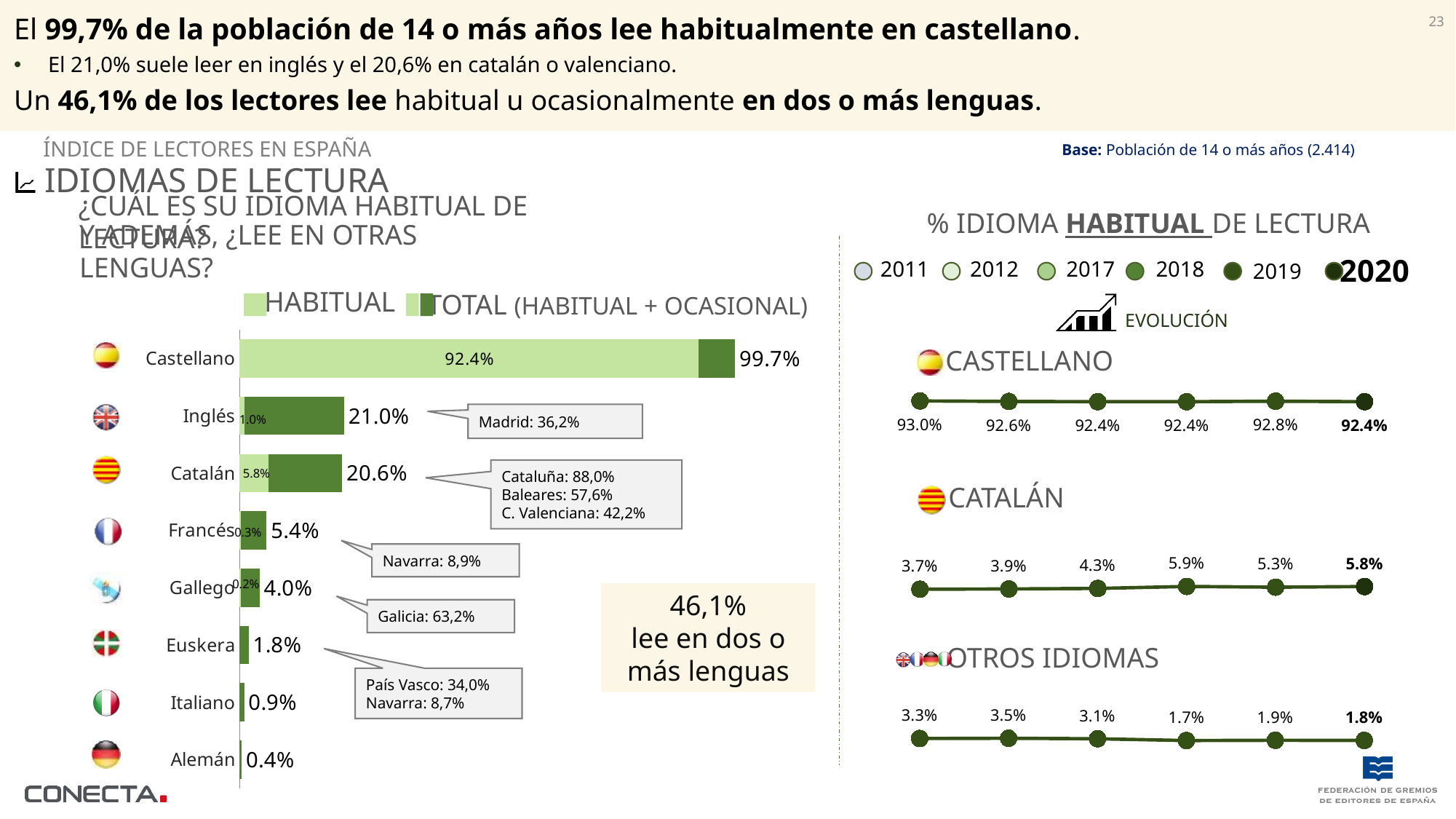
In the left bar chart, what is the HABITUAL value for Catalán? 5.8% In the left bar chart, which has the larger TOTAL value, Inglés or Catalán? Inglés In the left bar chart, what is the TOTAL (habitual + ocasional) value for Inglés? 21.0% In the left bar chart, which language has the lowest TOTAL value? Alemán What kind of chart is the chart on the left of the slide? Bar chart In the left bar chart, what is the difference between the TOTAL and HABITUAL values for Castellano? 7.3% In the CASTELLANO line chart on the right, what is the value for 2011? 93.0% How many series does the legend of the left bar chart list? 2 In the OTROS IDIOMAS line chart on the right, do the values rise or fall from 2011 to 2020? Fall In the CATALÁN line chart on the right, which year has the highest value? 2018 In the left bar chart, which language has the highest TOTAL value? Castellano How many languages are listed in the left bar chart? 8